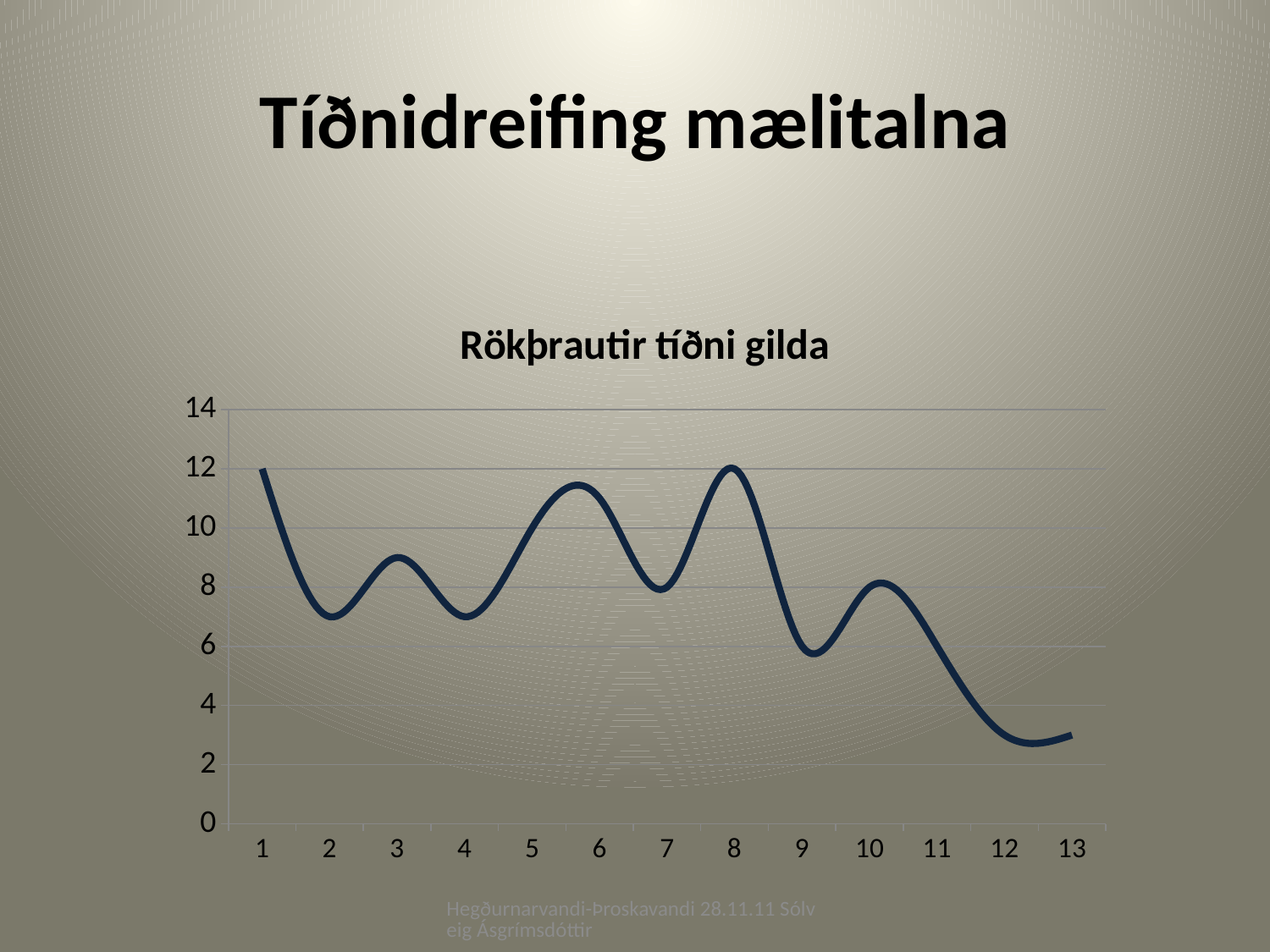
Is the value at x = 2 greater or less than 8? less Is the value at x = 12 greater or less than 4? less Which has the larger value, x = 1 or x = 2? 1 Overall, do the values rise or fall from x = 1 to x = 13? fall What is the title of the chart? Rökþrautir tíðni gilda Is the value at x = 1 greater or less than 10? greater Which has the larger value, x = 13 or x = 10? 10 How many points are plotted along the x axis of the chart? 13 Which has the larger value, x = 8 or x = 9? 8 What kind of chart is shown on the slide? line chart